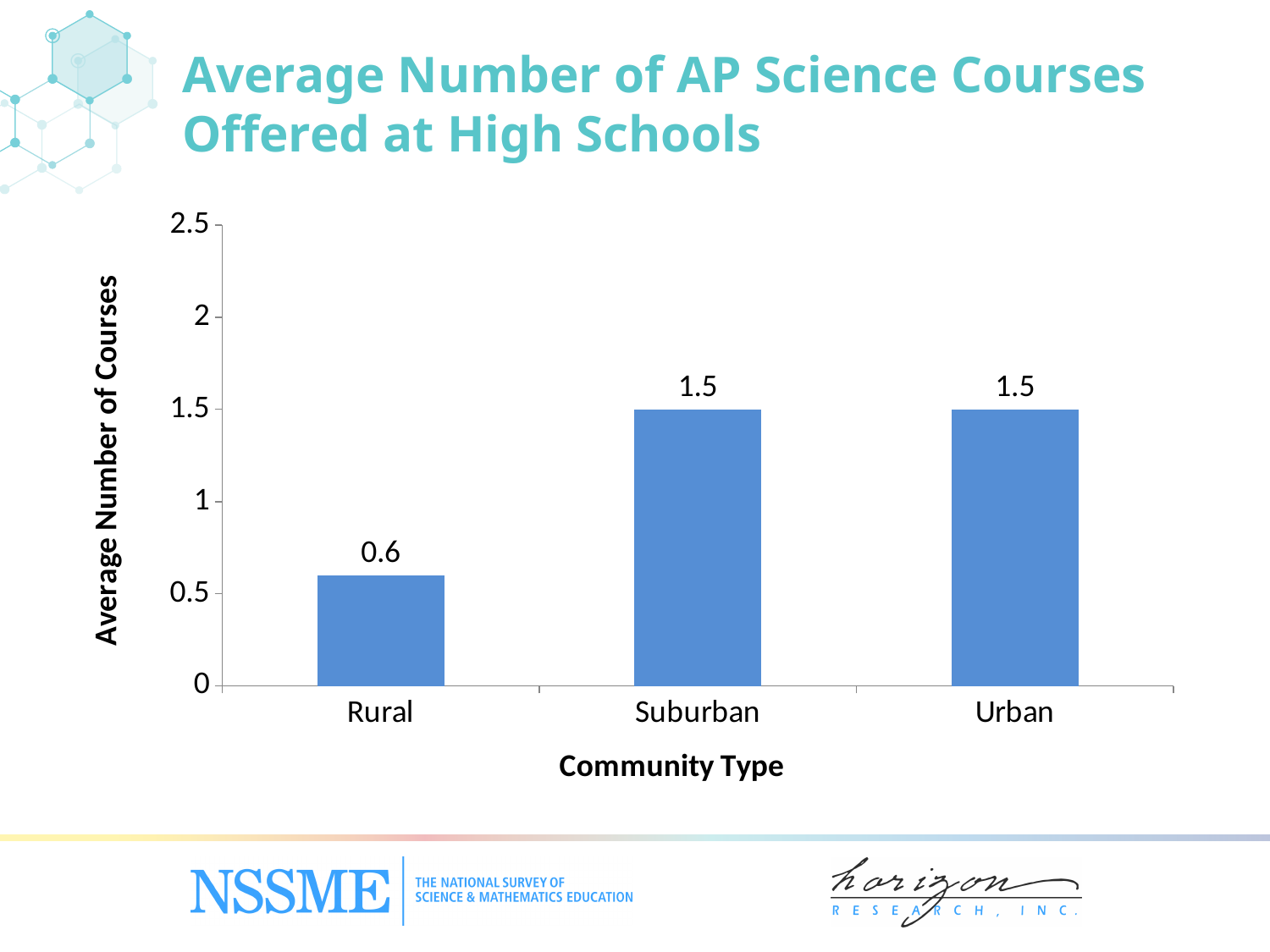
Which community type has the lowest average number of AP science courses? Rural What is the difference between the average number of AP science courses at suburban and rural high schools? 0.9 How many community types are shown on the chart? 3 What is the average number of AP science courses offered at rural high schools? 0.6 What is the label of the x axis? Community Type What is the average number of AP science courses offered at urban high schools? 1.5 What kind of chart is shown on the slide? Bar chart What is the label of the y axis? Average Number of Courses Is the value for Rural greater or less than 1? less Which is larger, the value for Urban or the value for Rural? Urban What is the average number of AP science courses offered at suburban high schools? 1.5 Is the value for Suburban greater or less than 2? less